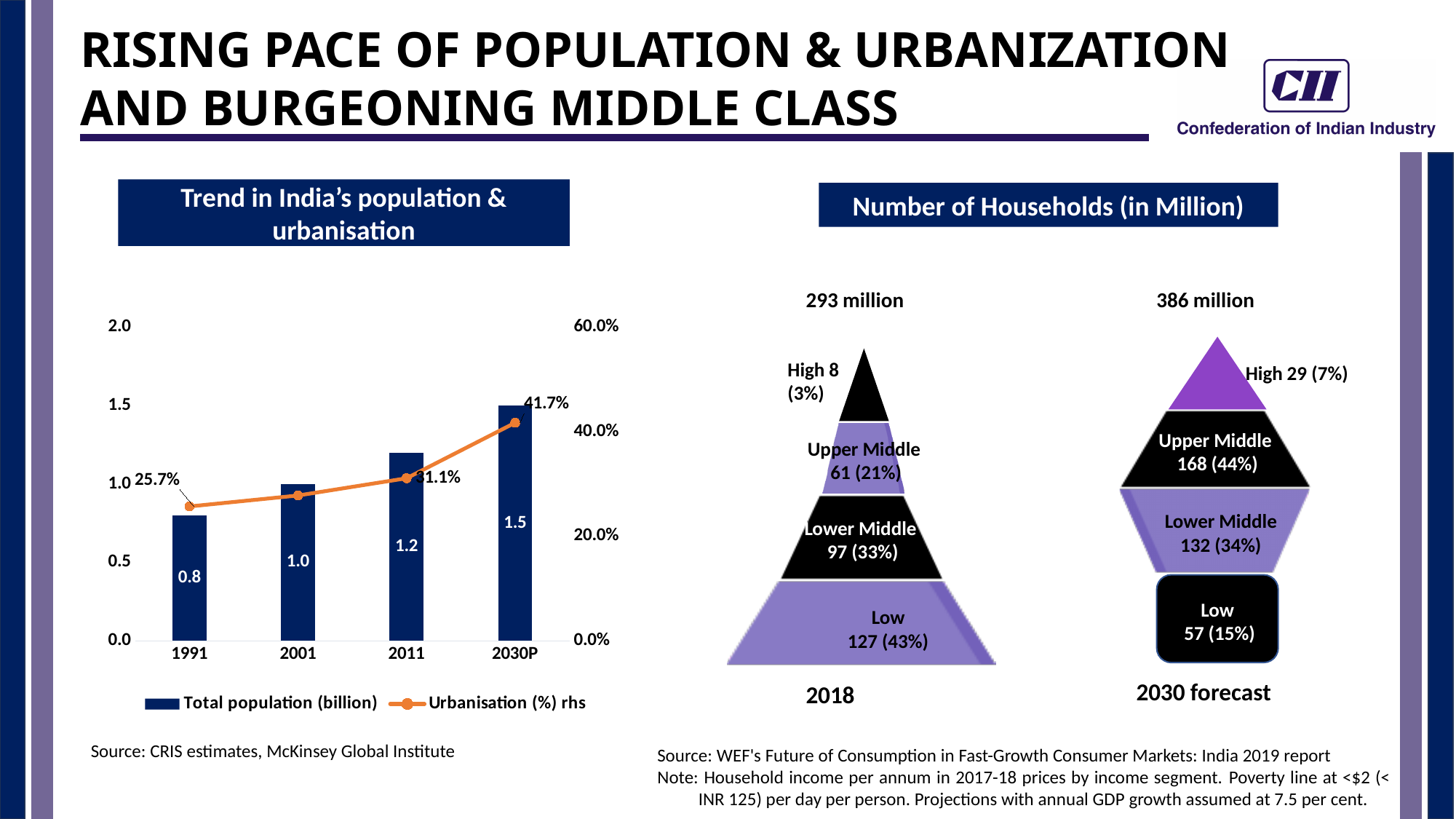
In the 'Trend in India's population & urbanisation' chart, is the urbanisation value for 2001 greater or less than 40.0%? less In the 'Trend in India's population & urbanisation' chart, how many years are shown on the x axis? 4 In the 'Trend in India's population & urbanisation' chart, which year has the lowest total population? 1991 In the 'Trend in India's population & urbanisation' chart, what is the urbanisation percentage for 1991? 25.7% In the 'Trend in India's population & urbanisation' chart, does the urbanisation line rise or fall from 1991 to 2030P? rise In the 'Number of Households (in Million)' graphic, what is the total number of households in 2018? 293 million In the 'Trend in India's population & urbanisation' chart, what is the urbanisation percentage for 2030P? 41.7% In the 'Trend in India's population & urbanisation' chart, which year has the highest total population? 2030P In the 'Trend in India's population & urbanisation' chart, what is the difference in total population between 2030P and 1991? 0.7 In the 'Trend in India's population & urbanisation' chart, what is the total population for 2011? 1.2 In the 'Number of Households (in Million)' graphic, how many Upper Middle households are forecast for 2030? 168 (44%) In the 'Trend in India's population & urbanisation' chart, how many series does the legend list? 2